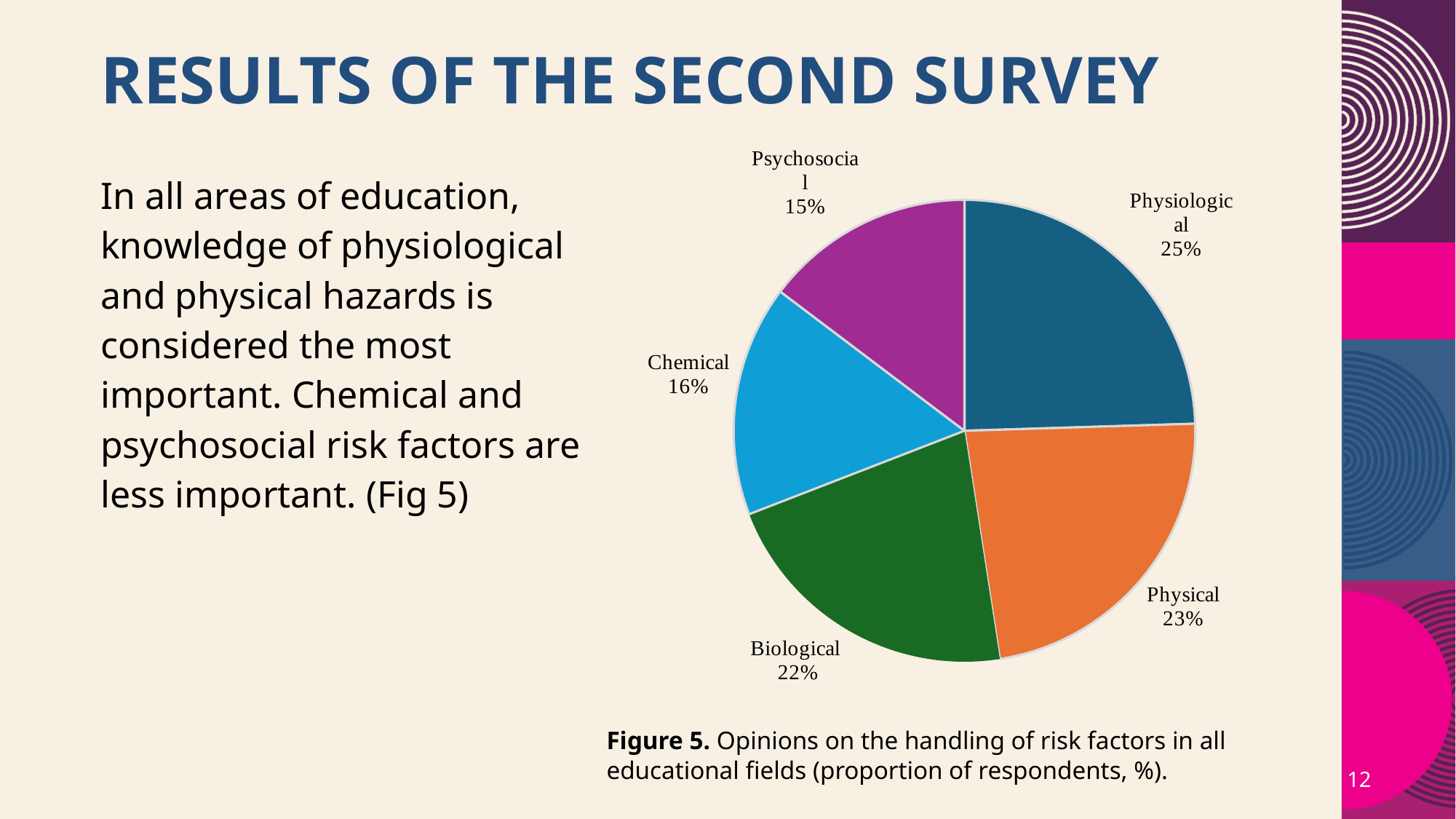
What kind of chart is shown on the slide? pie chart What is the difference in percentage points between the Physiological and Psychosocial slices? 10 What is the combined share of the Chemical and Psychosocial slices? 31% What percentage is shown for the Biological slice? 22% What percentage is shown for the Chemical slice? 16% How many slices does the pie chart have? 5 Which risk factor category has the largest share of the pie? Physiological Which risk factor category has the smallest share of the pie? Psychosocial What colour is the Biological slice? green Which slice is larger, Physical or Biological? Physical What share of respondents does the Physiological slice represent? 25% What percentage is shown for the Psychosocial slice? 15%